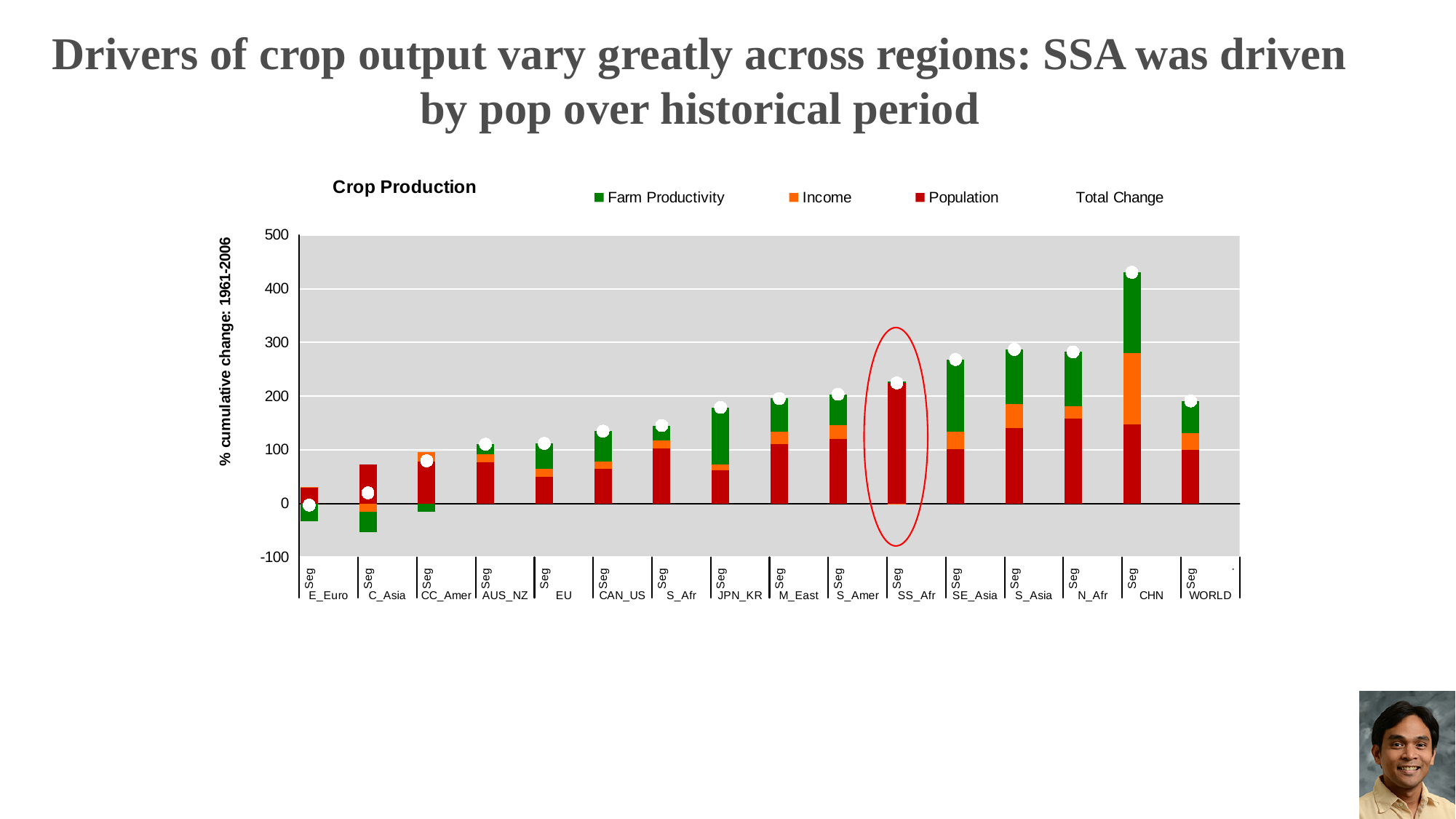
Do the Total Change values generally rise or fall along the x axis from E_Euro to CHN? rise Which region's bar is circled in red on the chart? SS_Afr Which region has the highest Total Change in the Crop Production chart? CHN What kind of chart is shown on the slide? Stacked bar chart with Total Change overlaid as point markers (combination bar and line chart) How many series does the legend of the Crop Production chart list? 4 Which has the larger Total Change, SS_Afr or EU? SS_Afr Is the Total Change value for E_Euro greater or less than 100? less Which has the larger Total Change, CHN or N_Afr? CHN Is the Total Change value for N_Afr greater or less than 250? greater Is the Total Change value for SS_Afr greater or less than 200? greater How many regions (categories) are plotted along the x axis of the Crop Production chart? 16